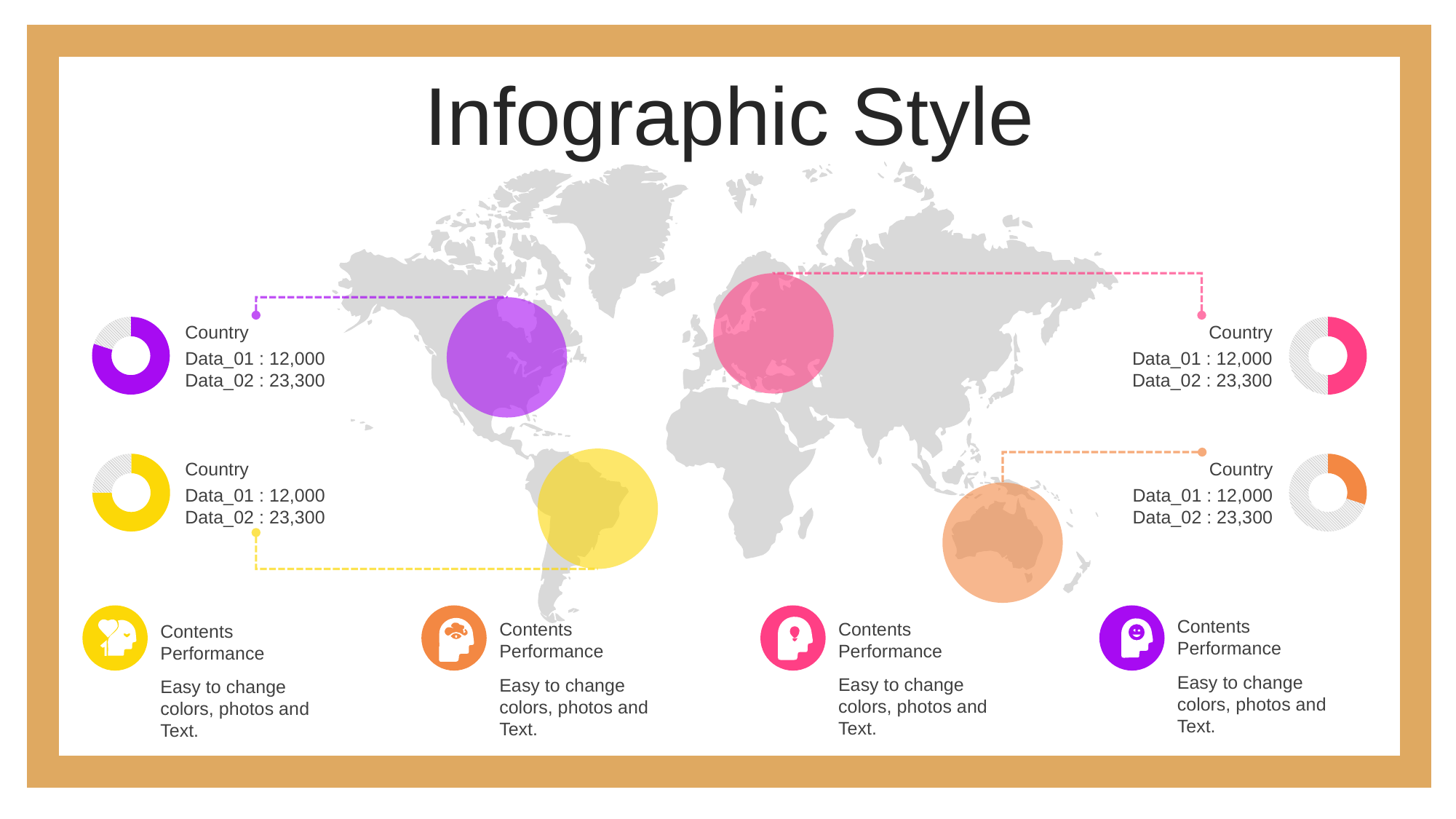
For the top-left doughnut chart, what value is listed for Data_02? 23,300 What colour is the filled segment of the bottom-right doughnut chart? orange For the top-left doughnut chart, what value is listed for Data_01? 12,000 How many small doughnut charts are shown on the slide? 4 What kind of chart is the small chart at the top left of the slide, next to the first 'Country' label? doughnut chart How many segments does the top-left doughnut chart have? 2 For the bottom-right doughnut chart, what value is listed for Data_02? 23,300 For the bottom-left doughnut chart, which listed value is larger, Data_01 or Data_02? Data_02 For the top-left doughnut chart, is the listed Data_01 value greater or less than 20,000? less What colour is the filled segment of the top-left doughnut chart? purple For the top-right doughnut chart, what is the difference between the listed Data_02 and Data_01 values? 11,300